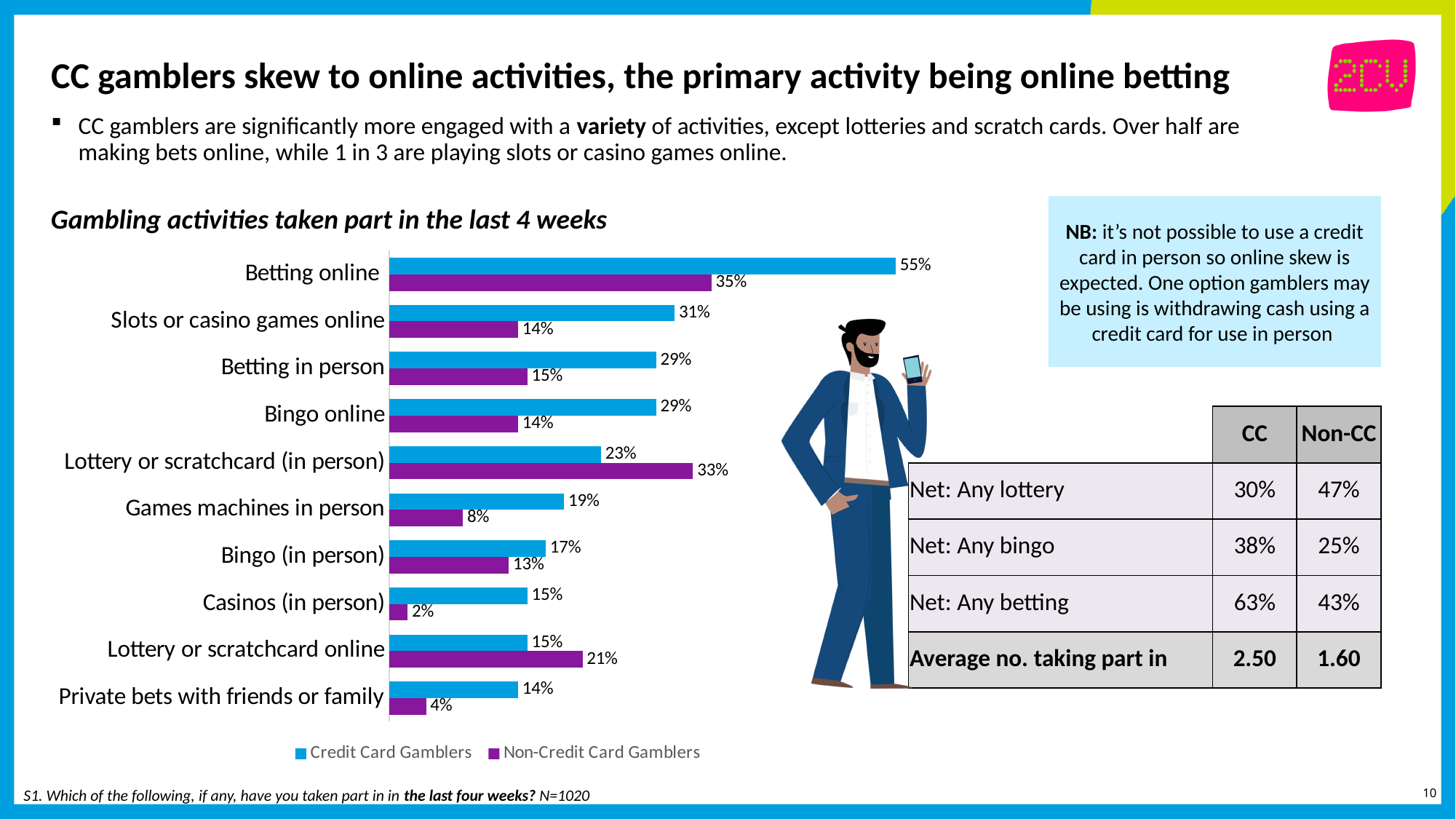
How many series does the legend list? 2 How many activities are shown in the chart? 10 What is the difference between Credit Card Gamblers and Non-Credit Card Gamblers for Betting online? 20 percentage points Which colour represents Non-Credit Card Gamblers in the chart? Purple What kind of chart is shown on the slide? Bar chart What percentage of Non-Credit Card Gamblers took part in Lottery or scratchcard (in person)? 33% What percentage of Credit Card Gamblers took part in Betting online? 55% What percentage of Non-Credit Card Gamblers took part in Casinos (in person)? 2% What is the title of the chart? Gambling activities taken part in the last 4 weeks For Lottery or scratchcard online, which group has the larger value: Credit Card Gamblers or Non-Credit Card Gamblers? Non-Credit Card Gamblers Which activity has the lowest value for Non-Credit Card Gamblers? Casinos (in person) Which activity has the highest value for Credit Card Gamblers? Betting online